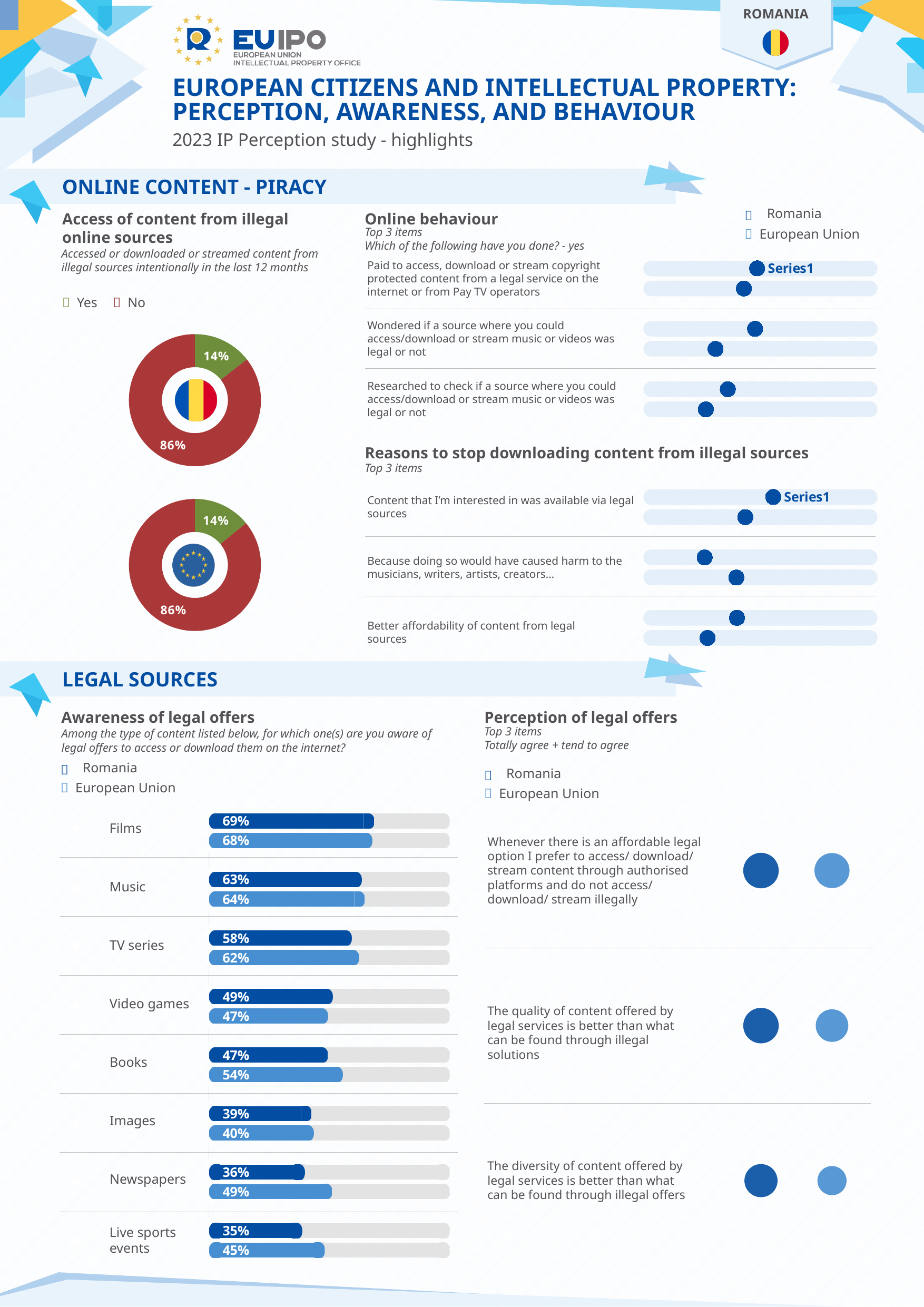
In the 'Awareness of legal offers' chart, what is the European Union value for Newspapers? 49% In the 'Awareness of legal offers' chart, what is the Romania value for Films? 69% In the 'Awareness of legal offers' chart, is the Romania value for Books higher or lower than the European Union value for Books? lower In the Romania donut chart under 'Access of content from illegal online sources', what percentage answered Yes? 14% What kind of chart is used for 'Awareness of legal offers'? bar chart In the 'Awareness of legal offers' chart, which content type has the highest Romania value? Films In the 'Awareness of legal offers' chart, which content type has the lowest European Union value? Images In the 'Awareness of legal offers' chart, what is the Romania value for Live sports events? 35% In the European Union donut chart under 'Access of content from illegal online sources', what percentage answered No? 86% How many series does the legend of the 'Awareness of legal offers' chart list? 2 How many content types are listed in the 'Awareness of legal offers' chart? 8 In the 'Awareness of legal offers' chart, what is the difference between the European Union and Romania values for Newspapers? 13%